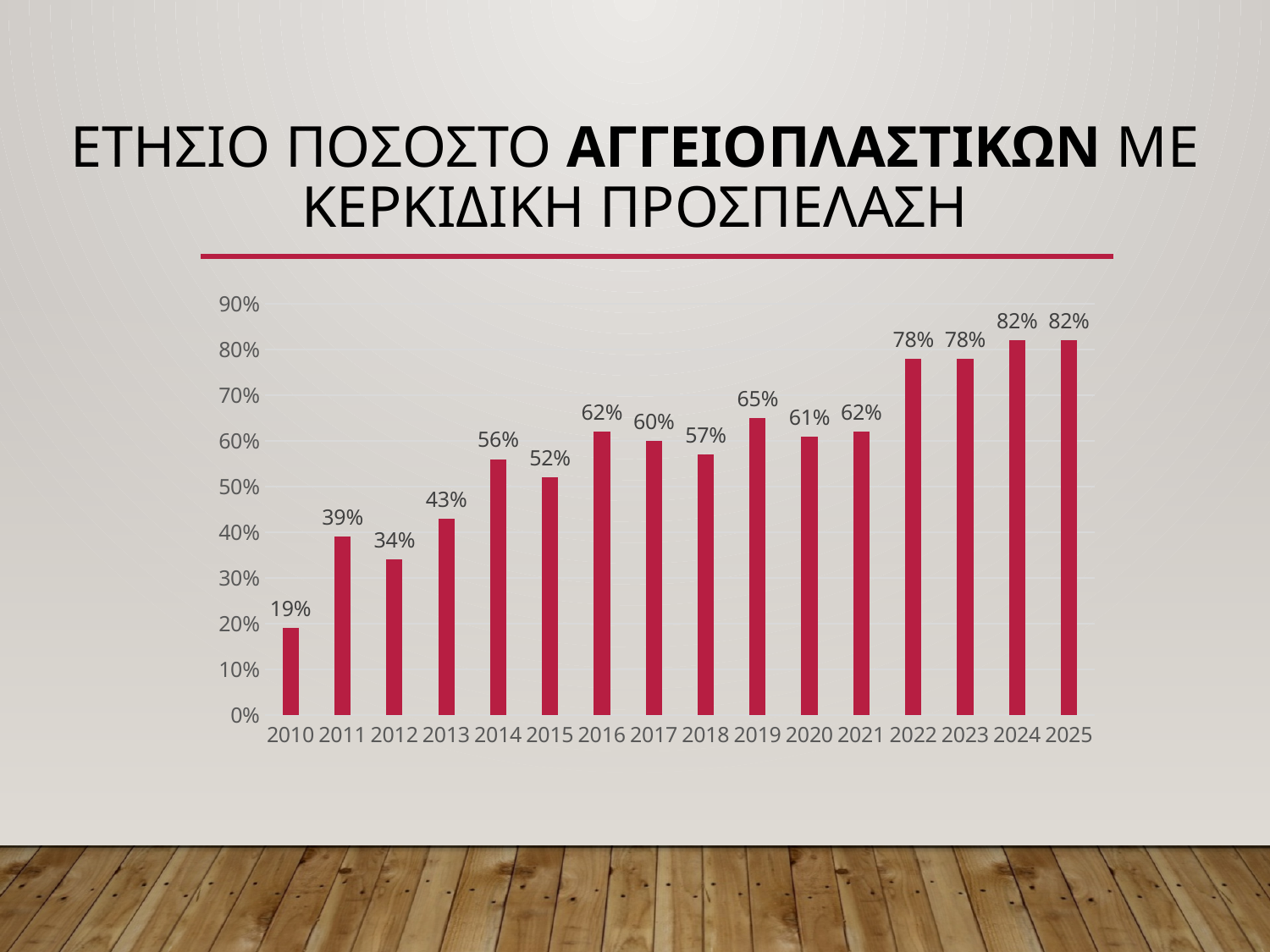
What is the highest value shown on the chart? 82% Do the values generally rise or fall from 2010 to 2025? rise What is the value for 2022? 78% How many years are shown on the x axis? 16 What kind of chart is this? bar chart Is the value for 2018 greater or less than 50%? greater What is the value for 2019? 65% Which is larger, the value for 2012 or the value for 2013? 2013 Which year has the lowest value? 2010 What is the value for 2010? 19% What is the difference between the values for 2025 and 2010? 63% What is the difference between the values for 2016 and 2015? 10%